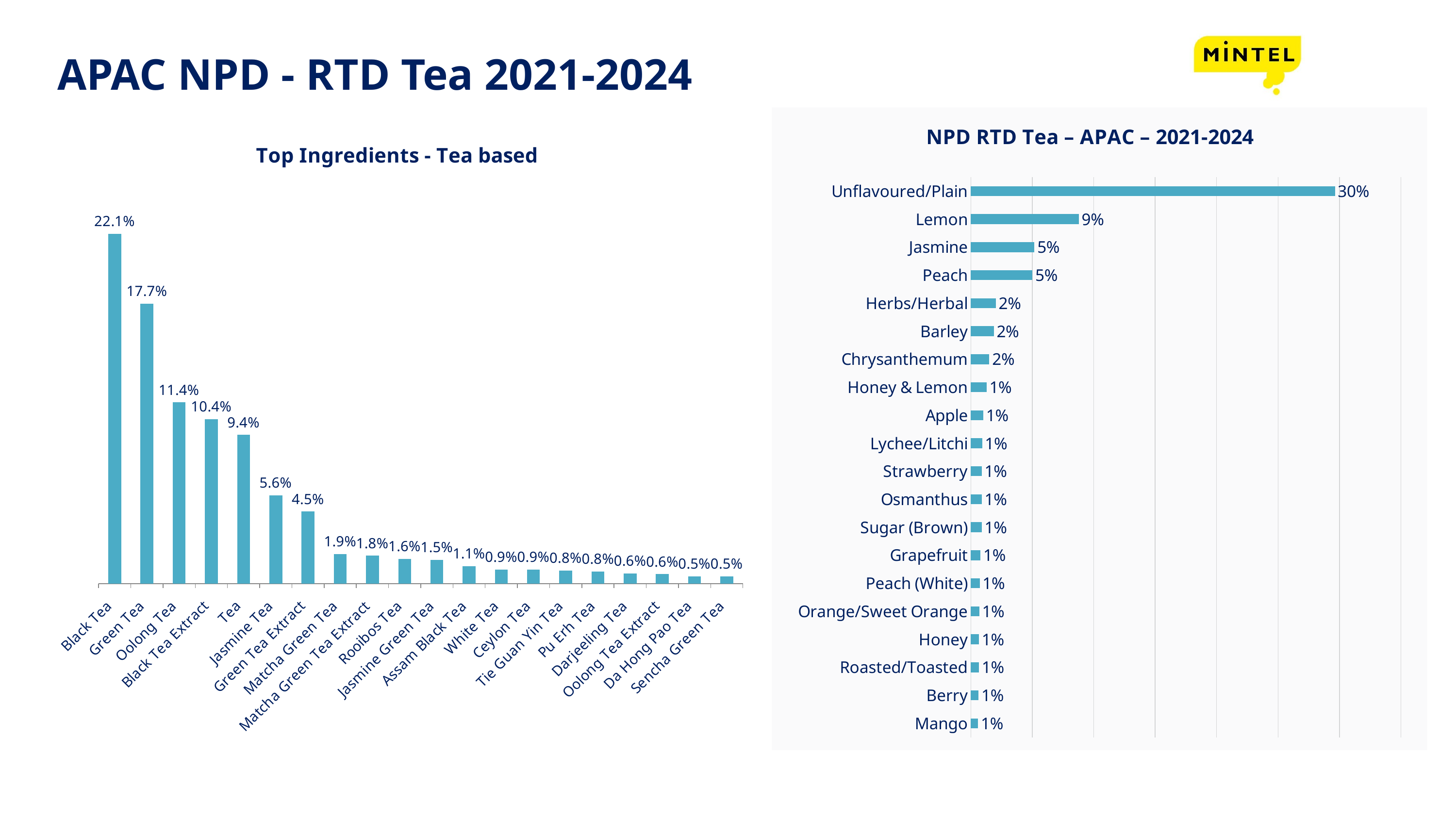
In the 'NPD RTD Tea – APAC – 2021-2024' chart, what is the value for Lemon? 9% In the 'Top Ingredients - Tea based' chart, what is the difference between Black Tea and Green Tea? 4.4% In the 'Top Ingredients - Tea based' chart, which is larger, Jasmine Tea or Green Tea Extract? Jasmine Tea In the 'Top Ingredients - Tea based' chart, how many ingredients are shown? 20 In the 'NPD RTD Tea – APAC – 2021-2024' chart, what is the difference between Unflavoured/Plain and Lemon? 21% In the 'Top Ingredients - Tea based' chart, what is the value for Oolong Tea? 11.4% In the 'NPD RTD Tea – APAC – 2021-2024' chart, what is the value for Unflavoured/Plain? 30% In the 'Top Ingredients - Tea based' chart, do the values rise or fall from left to right? fall In the 'Top Ingredients - Tea based' chart, what is the value for Black Tea? 22.1% What kind of chart is the 'NPD RTD Tea – APAC – 2021-2024' chart? bar chart In the 'NPD RTD Tea – APAC – 2021-2024' chart, how many flavours are listed? 20 In the 'Top Ingredients - Tea based' chart, which ingredient has the highest value? Black Tea